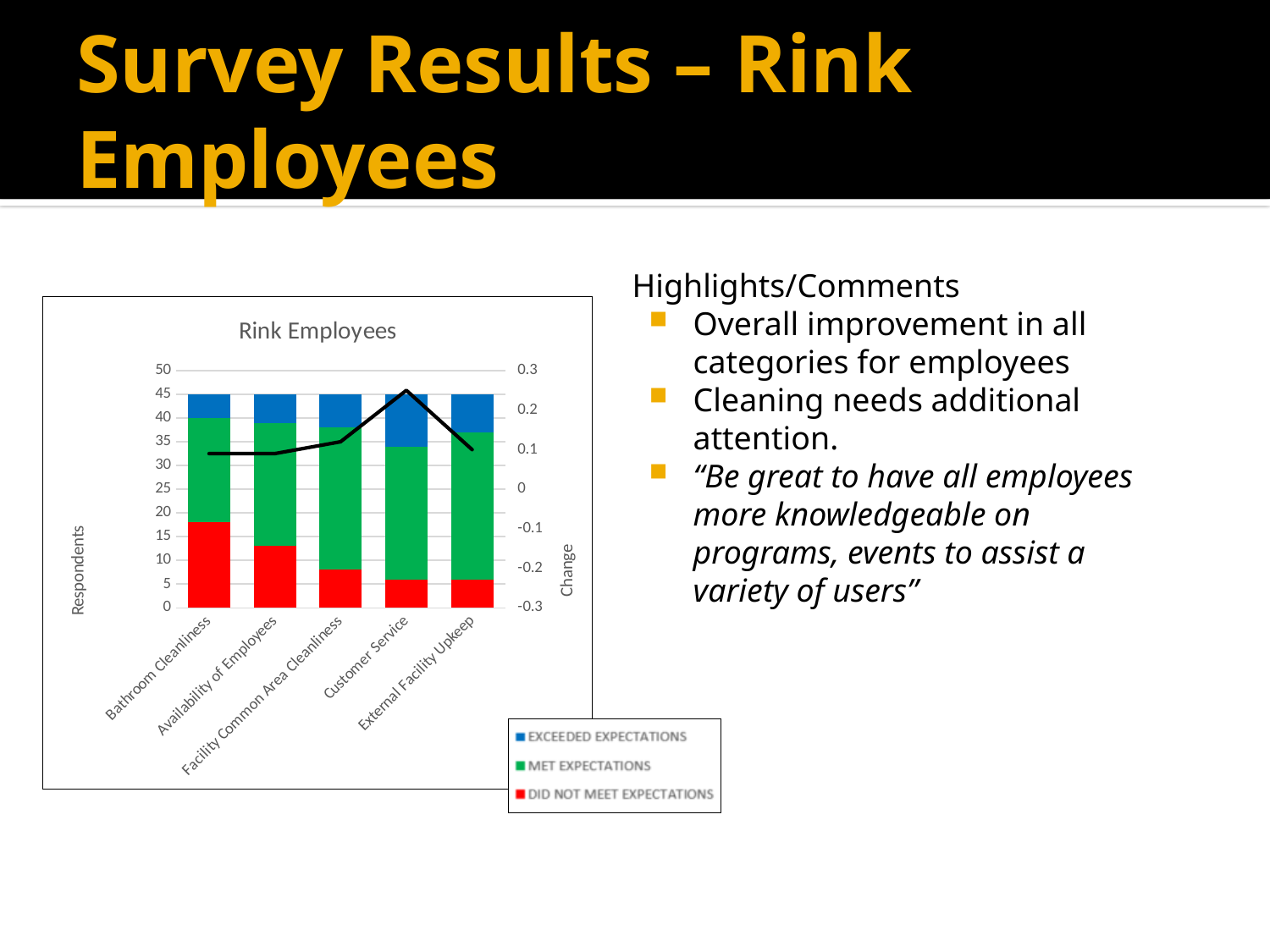
How many series does the chart's legend list? 3 How many categories are shown on the x axis of the chart? 5 Which category has the largest Exceeded Expectations segment? Customer Service Is the Did Not Meet Expectations value for Bathroom Cleanliness greater or less than 15? greater Which category has the largest Did Not Meet Expectations segment? Bathroom Cleanliness Is the Did Not Meet Expectations value for Facility Common Area Cleanliness greater or less than 10? less What is the title of the chart? Rink Employees What is the label on the left vertical axis of the chart? Respondents Which has the larger Did Not Meet Expectations value, Bathroom Cleanliness or Availability of Employees? Bathroom Cleanliness Is the Change line value for Customer Service greater or less than 0.2? greater At which category does the Change line reach its highest point? Customer Service What kind of chart is shown on the slide? Stacked bar chart with a line